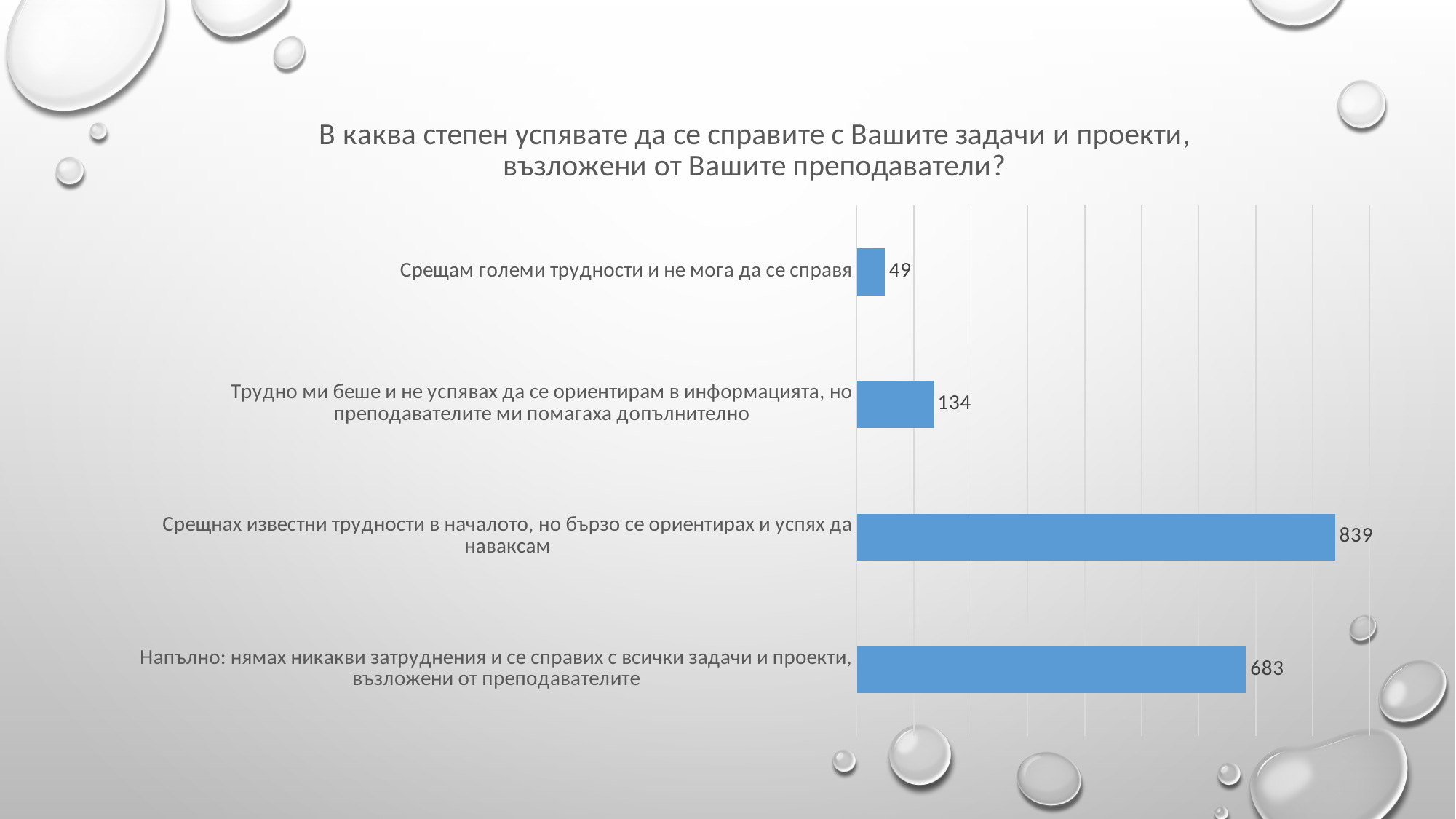
What is the title of the chart? В каква степен успявате да се справите с Вашите задачи и проекти, възложени от Вашите преподаватели? Which category has the lowest value? Срещам големи трудности и не мога да се справя What value is shown for the category "Напълно: нямах никакви затруднения и се справих с всички задачи и проекти, възложени от преподавателите"? 683 What is the difference between the values for "Трудно ми беше и не успявах да се ориентирам в информацията, но преподавателите ми помагаха допълнително" and "Срещам големи трудности и не мога да се справя"? 85 Which category has the highest value? Срещнах известни трудности в началото, но бързо се ориентирах и успях да наваксам What value is shown for the category "Срещам големи трудности и не мога да се справя"? 49 What value is shown for the category "Срещнах известни трудности в началото, но бързо се ориентирах и успях да наваксам"? 839 How many categories are shown in the chart? 4 What kind of chart is shown on the slide? Bar chart What value is shown for the category "Трудно ми беше и не успявах да се ориентирам в информацията, но преподавателите ми помагаха допълнително"? 134 Which is larger: the value for "Напълно: нямах никакви затруднения и се справих с всички задачи и проекти, възложени от преподавателите" or the value for "Трудно ми беше и не успявах да се ориентирам в информацията, но преподавателите ми помагаха допълнително"? Напълно: нямах никакви затруднения и се справих с всички задачи и проекти, възложени от преподавателите What is the difference between the values for "Срещнах известни трудности в началото, но бързо се ориентирах и успях да наваксам" and "Напълно: нямах никакви затруднения и се справих с всички задачи и проекти, възложени от преподавателите"? 156